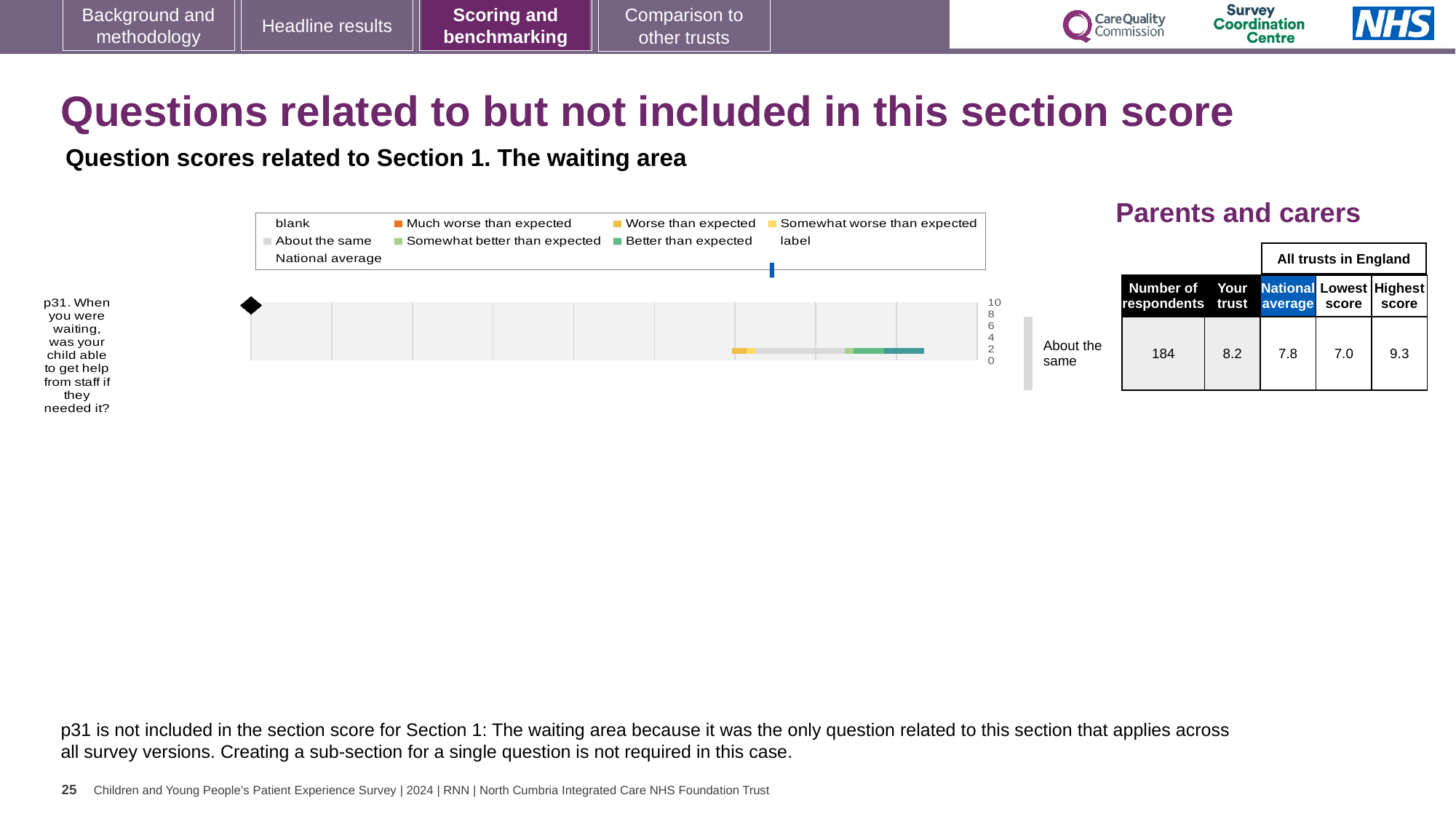
Is the 'Your trust' score for p31 larger or smaller than the national average? larger Which question is plotted in the chart? p31. When you were waiting, was your child able to get help from staff if they needed it? Which legend entry is shown in orange? Much worse than expected In the table, what is the highest score among all trusts in England for p31? 9.3 What benchmark category label is shown to the right of the chart for p31? About the same In the table, what is the national average score for p31? 7.8 What kind of chart is used to show the p31 question score? bar chart What is the difference between the highest score and the lowest score for p31 in the table? 2.3 How many questions are plotted in the chart? 1 In the table, what is the number of respondents for p31? 184 In the table, what is the 'Your trust' score for p31? 8.2 In the table, what is the lowest score among all trusts in England for p31? 7.0